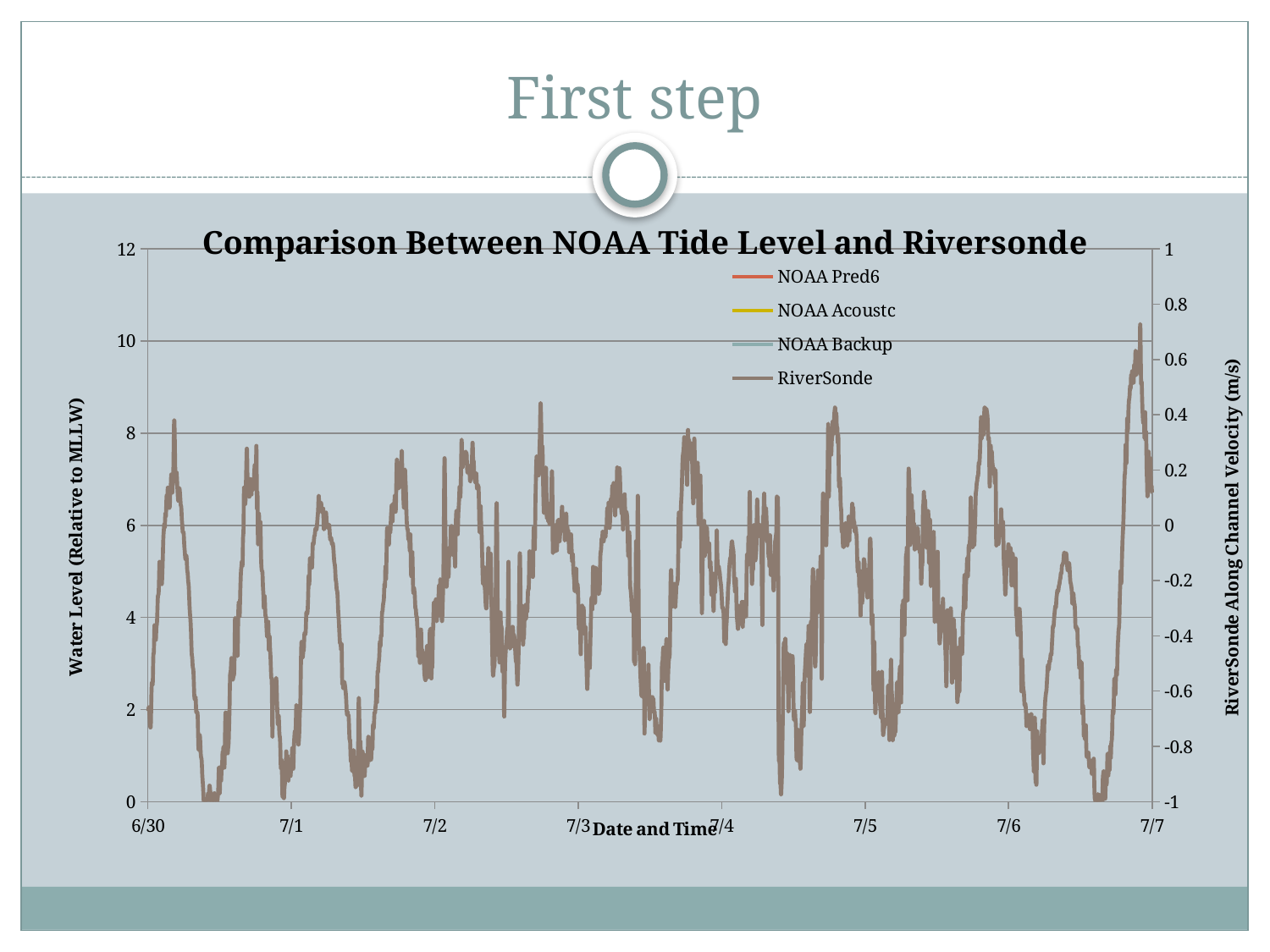
How many series does the chart's legend list? 4 Is the value of the plotted line at 6/30, read on the left axis, greater or less than 4? less Near which x-axis date does the plotted line reach its highest peak? 7/7 What is the maximum value shown on the left vertical axis? 12 What kind of chart is shown on the slide? line chart What is the label of the left vertical axis? Water Level (Relative to MLLW) Is the highest peak of the plotted line, read on the left axis, greater or less than 8? greater What is the title of the chart? Comparison Between NOAA Tide Level and Riversonde What is the last date shown on the x axis? 7/7 What is the first date shown on the x axis? 6/30 What is the minimum value shown on the right vertical axis? -1 How many date labels are shown along the x axis? 8